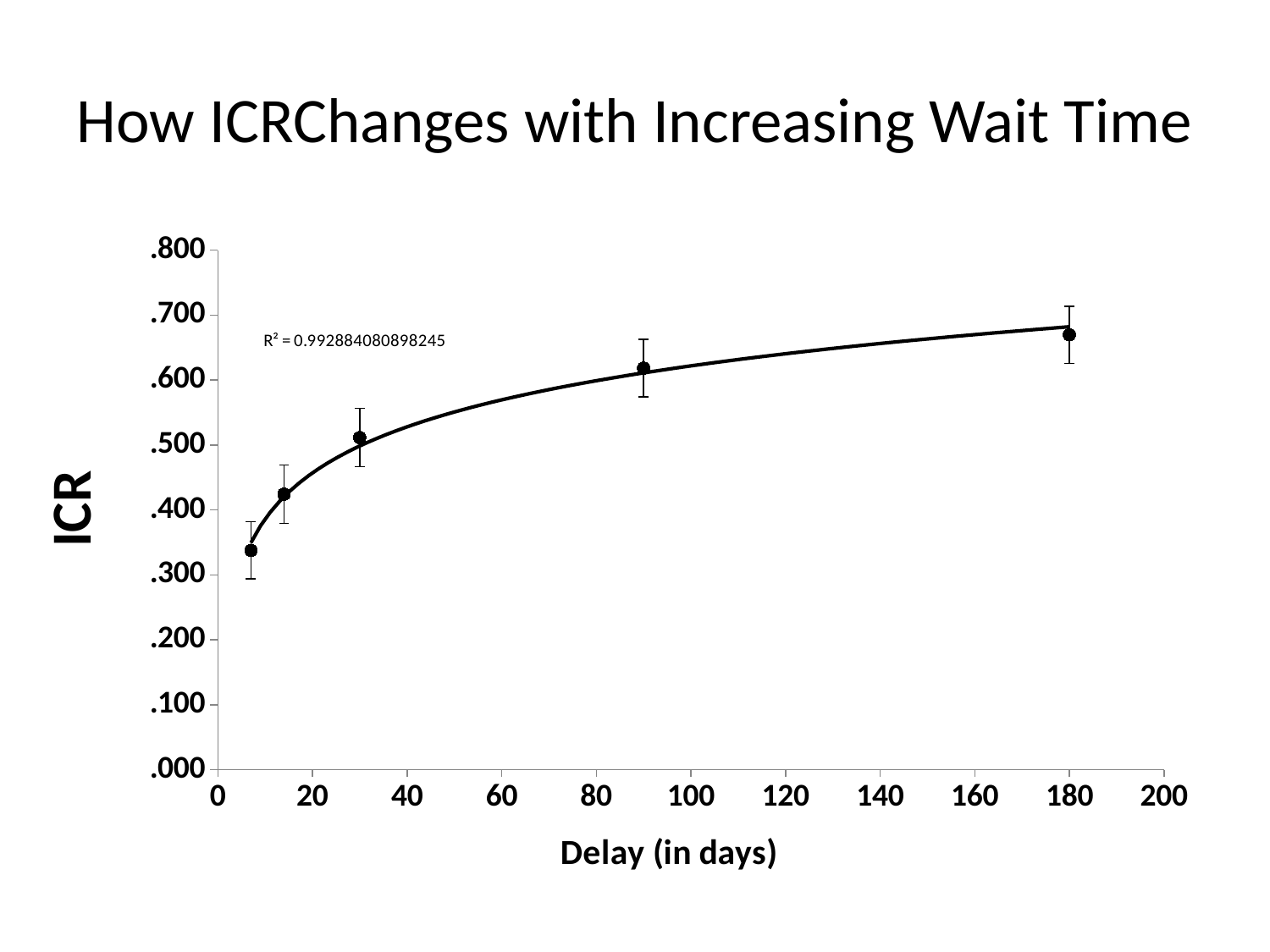
What is the label of the x axis? Delay (in days) Is the ICR value at the shortest delay (near 7 days) greater or less than .400? less Which has a larger ICR value: the point at 90 days or the point at about 14 days? 90 days Is the ICR value at a delay of about 14 days greater or less than .500? less How many data points are plotted on the chart? 5 Is the ICR value at a delay of 90 days greater or less than .500? greater Does ICR rise or fall as the delay in days increases? Rise What R² value is printed on the chart? 0.992884080898245 What kind of chart is shown on the slide? Scatter plot with a trend line What is the title of the chart? How ICRChanges with Increasing Wait Time Which delay has the highest ICR value? 180 days